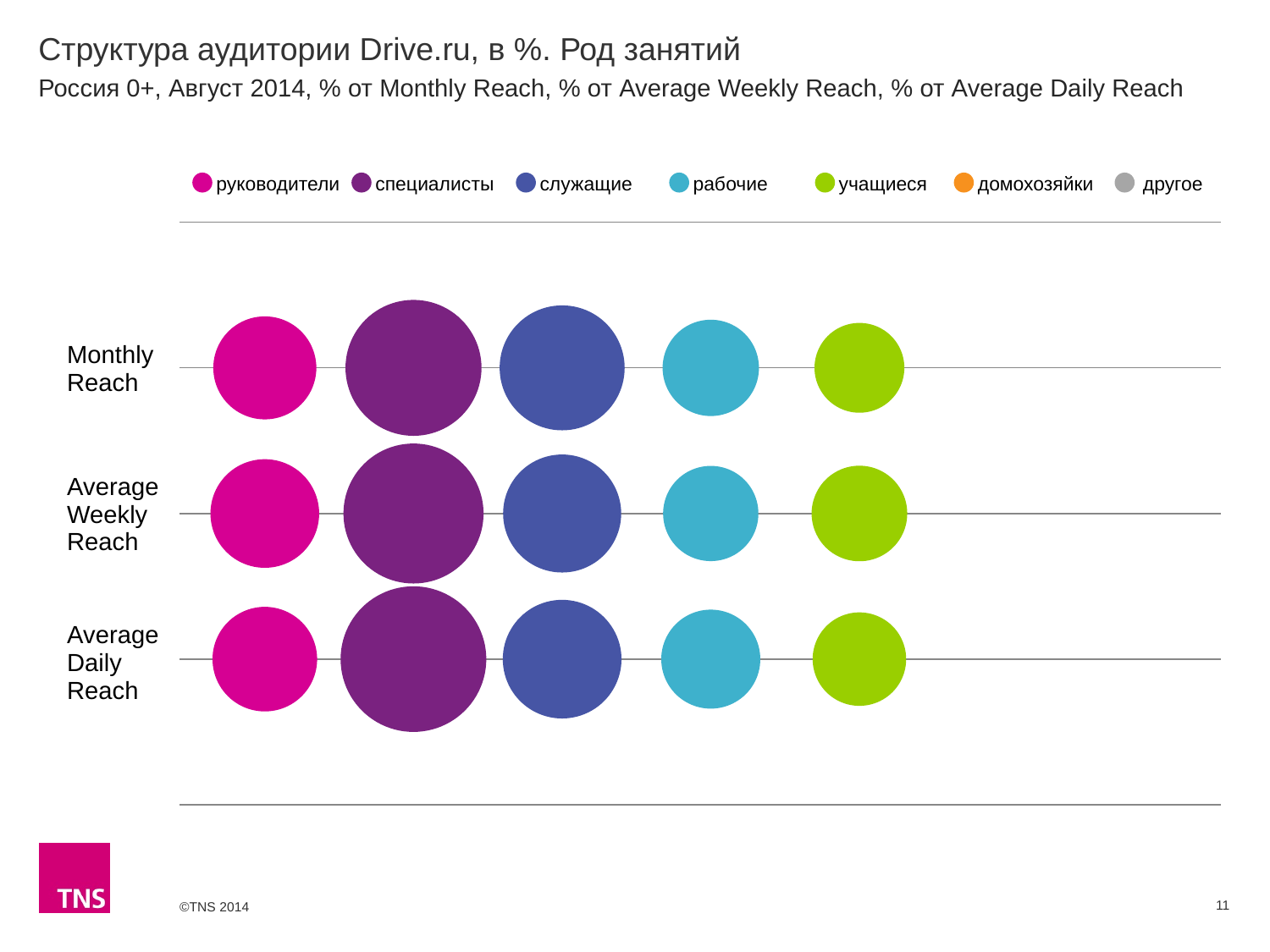
Which colour represents специалисты in the legend? purple What kind of chart is shown on the slide? bubble chart How many reach categories (rows) are plotted on the chart? 3 How many bubbles are visible in the Monthly Reach row? 5 In the Average Weekly Reach row, which bubble is larger: служащие or рабочие? служащие How many series does the legend list? 7 What is the title of the chart on the slide? Структура аудитории Drive.ru, в %. Род занятий In the Monthly Reach row, which bubble is larger: руководители or рабочие? руководители Which occupation has the largest bubble in the Monthly Reach row? специалисты Which occupation has the largest bubble in the Average Daily Reach row? специалисты In the Monthly Reach row, which bubble is larger: специалисты or руководители? специалисты